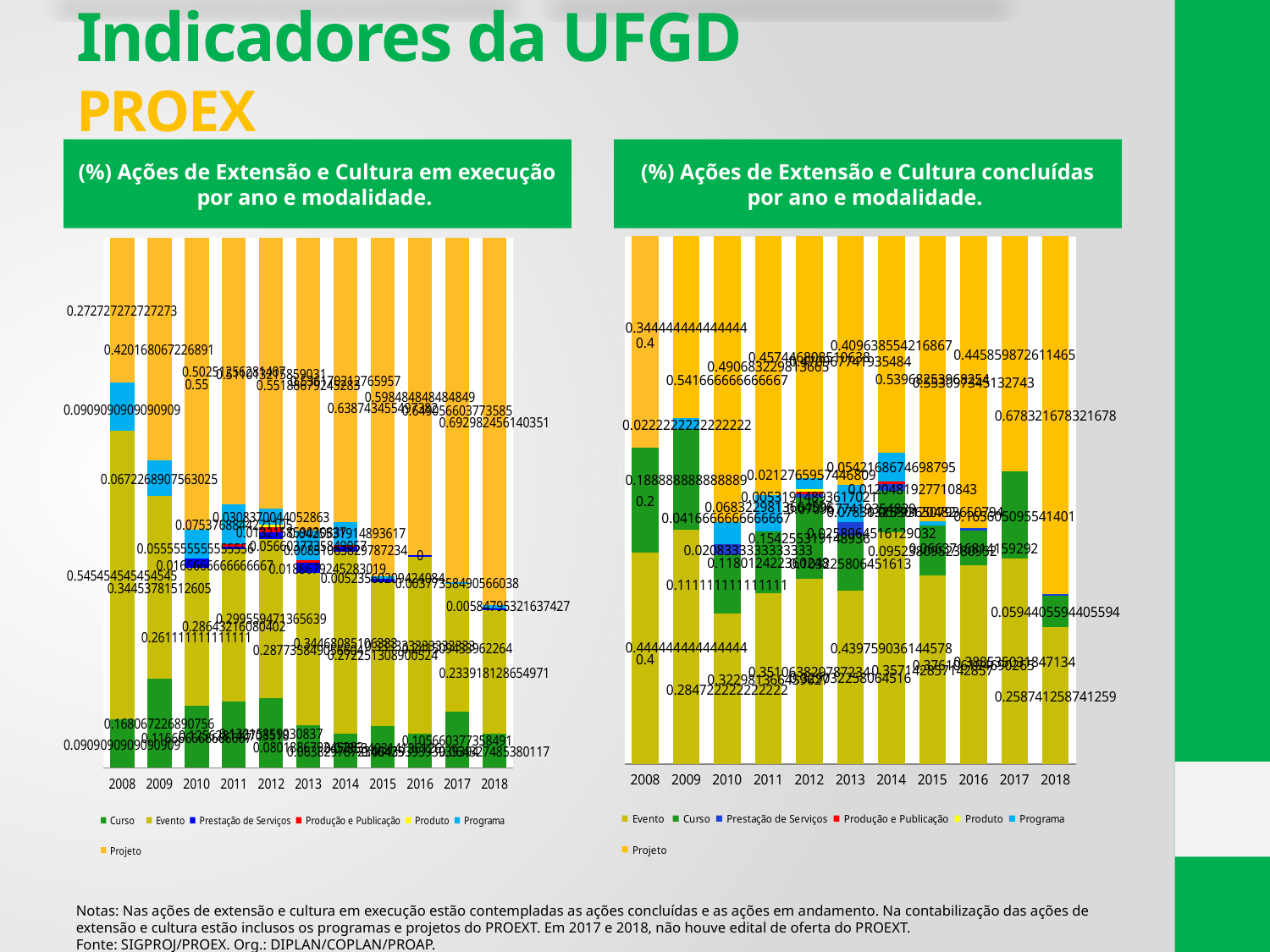
In the left chart '(%) Ações de Extensão e Cultura em execução por ano e modalidade', how many years are shown on the x axis? 11 In the right chart '(%) Ações de Extensão e Cultura concluídas por ano e modalidade', what is the value of Evento for 2008? 0.4 How many series does the legend of the right chart '(%) Ações de Extensão e Cultura concluídas por ano e modalidade' list? 7 In the left chart '(%) Ações de Extensão e Cultura em execução por ano e modalidade', what is the value of Projeto for 2018? 0.692982456140351 In the right chart '(%) Ações de Extensão e Cultura concluídas por ano e modalidade', what is the value of Projeto for 2017? 0.445859872611465 What type of chart is the left chart, '(%) Ações de Extensão e Cultura em execução por ano e modalidade'? Stacked bar chart In the left chart '(%) Ações de Extensão e Cultura em execução por ano e modalidade', what is the value of Projeto for 2009? 0.420168067226891 In the left chart '(%) Ações de Extensão e Cultura em execução por ano e modalidade', what is the value of Evento for 2008? 0.545454545454545 In the left chart '(%) Ações de Extensão e Cultura em execução por ano e modalidade', does the Projeto share generally rise or fall from 2008 to 2018? Rise In the left chart '(%) Ações de Extensão e Cultura em execução por ano e modalidade', is the Projeto value larger in 2008 or in 2018? 2018 In the right chart '(%) Ações de Extensão e Cultura concluídas por ano e modalidade', what is the value of Projeto for 2018? 0.678321678321678 In the left chart '(%) Ações de Extensão e Cultura em execução por ano e modalidade', what is the value of Projeto for 2008? 0.272727272727273